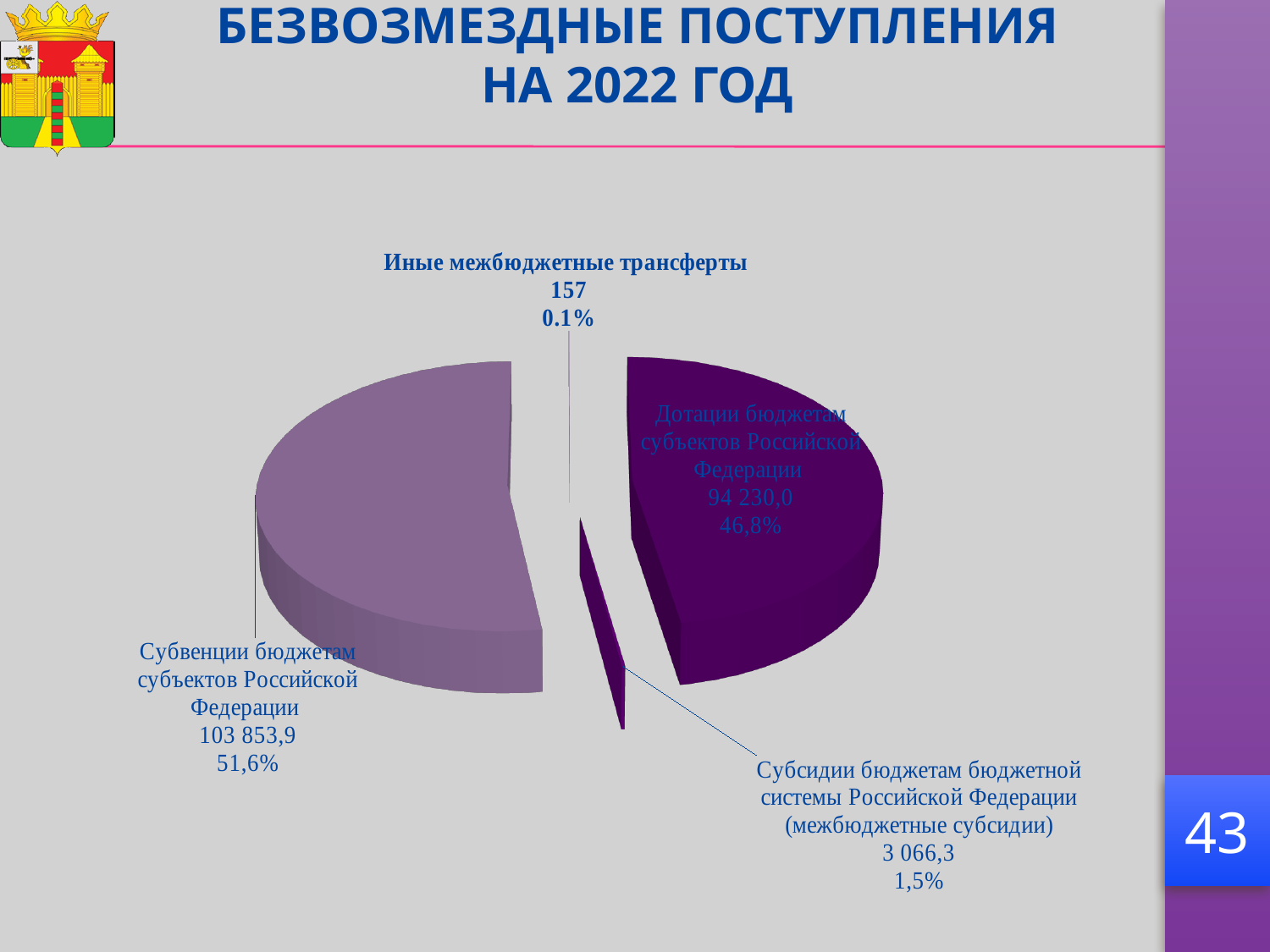
What is the title of the slide containing the chart? БЕЗВОЗМЕЗДНЫЕ ПОСТУПЛЕНИЯ НА 2022 ГОД How many slices does the pie chart have? 4 What is the value for Субсидии бюджетам бюджетной системы Российской Федерации (межбюджетные субсидии)? 3 066,3 What is the value for Иные межбюджетные трансферты? 157 What share of the pie does Субсидии бюджетам бюджетной системы Российской Федерации (межбюджетные субсидии) represent? 1,5% What is the value for Субвенции бюджетам субъектов Российской Федерации? 103 853,9 What is the difference between the values for Субвенции бюджетам субъектов Российской Федерации and Дотации бюджетам субъектов Российской Федерации? 9 623,9 What is the value for Дотации бюджетам субъектов Российской Федерации? 94 230,0 Which category has the largest slice of the pie? Субвенции бюджетам субъектов Российской Федерации What share of the pie does Дотации бюджетам субъектов Российской Федерации represent? 46,8% Which category has the smallest slice of the pie? Иные межбюджетные трансферты What type of chart is shown on the slide? Pie chart